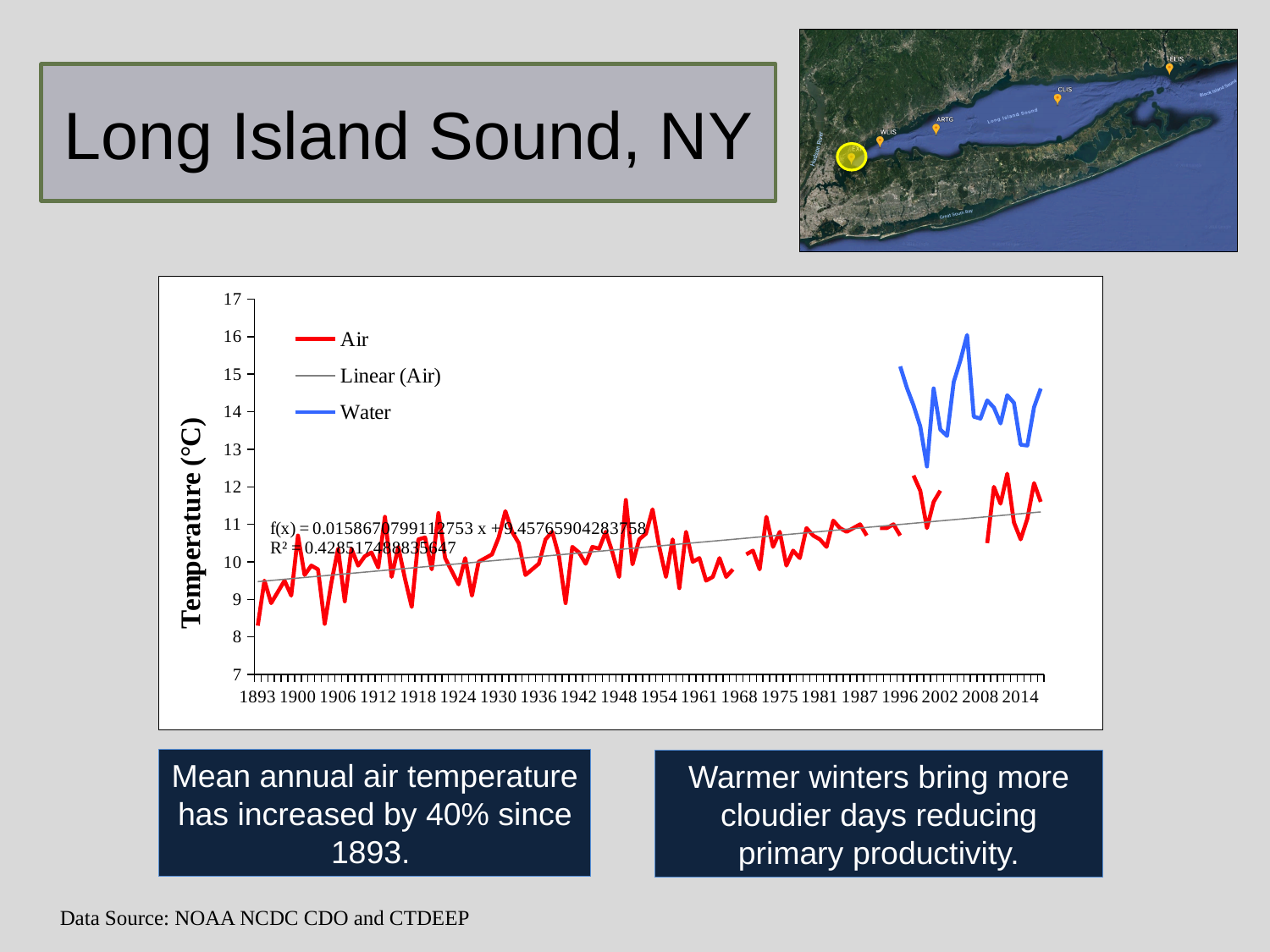
Is the highest value of the Water series greater or less than 15? greater In the years after 1996, which series has higher values, Water or Air? Water Is the highest value of the Air series greater or less than 13? less Does the Air temperature series generally rise or fall from 1893 to 2014? Rise What is the label on the vertical axis of the chart? Temperature (°C) Does the Linear (Air) trendline slope upward or downward across the years? Upward What are the three entries in the chart legend? Air, Linear (Air), Water Which series, Air or Water, covers the longer span of years on the chart? Air What kind of chart is shown on the slide? Line chart How many series does the chart legend list? 3 Is the Air value for 1893 greater or less than 10? less